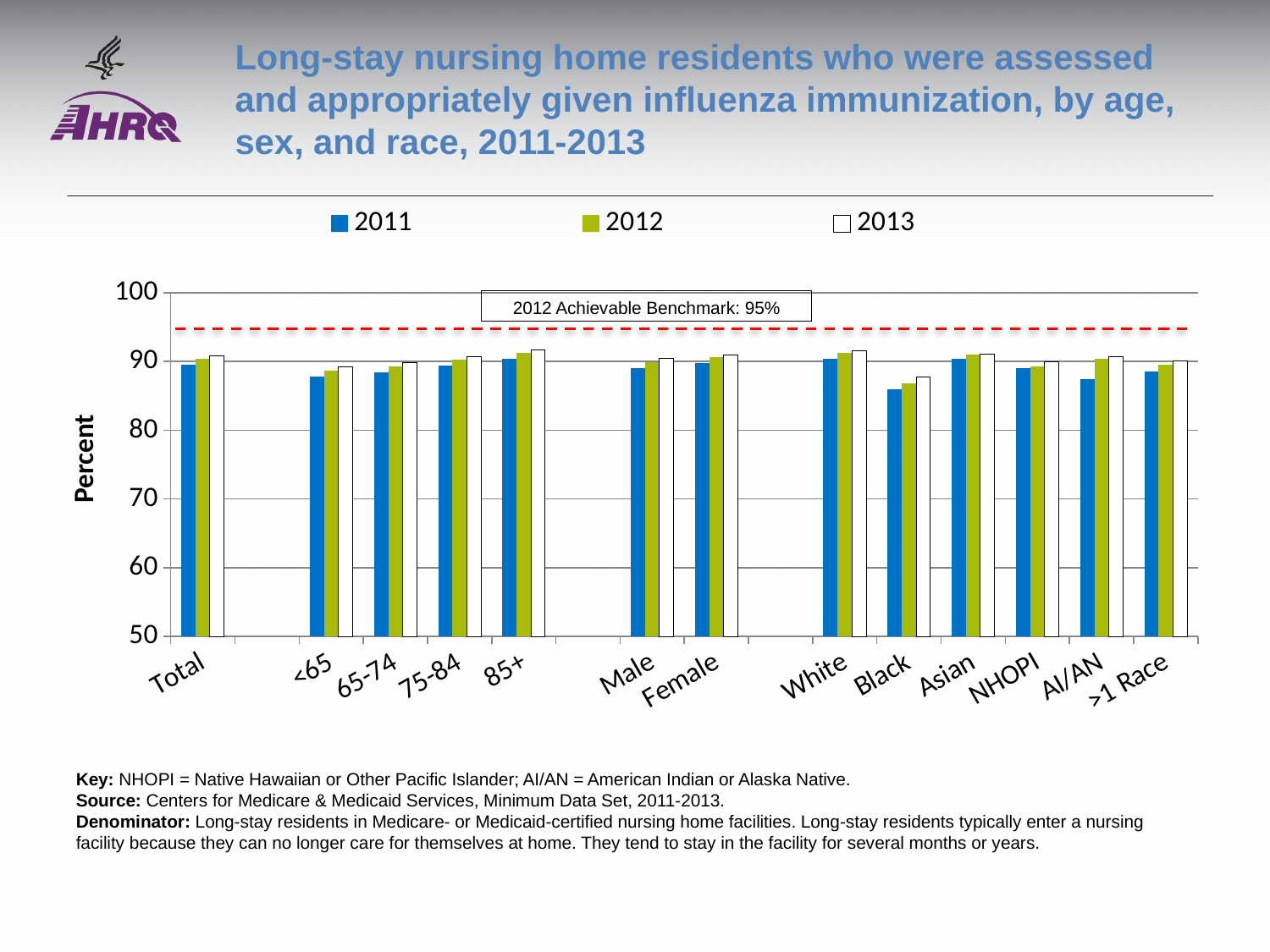
What kind of chart is shown on the slide? Bar chart Is the 2013 value for 85+ greater or less than 90? greater How many series does the legend list? 3 Within the Black category, do the values rise or fall from 2011 to 2013? rise What is the label on the y axis? Percent How many categories are shown along the x axis? 13 Which is larger, the 2011 value for <65 or the 2011 value for 85+? 85+ Which category has the lowest values across all three years? Black Is the 2011 value for Black greater or less than 90? less What is the 2012 achievable benchmark shown by the dashed line? 95% Is the 2011 value for Total greater or less than 80? greater Which is larger, the 2011 value for White or the 2011 value for Black? White